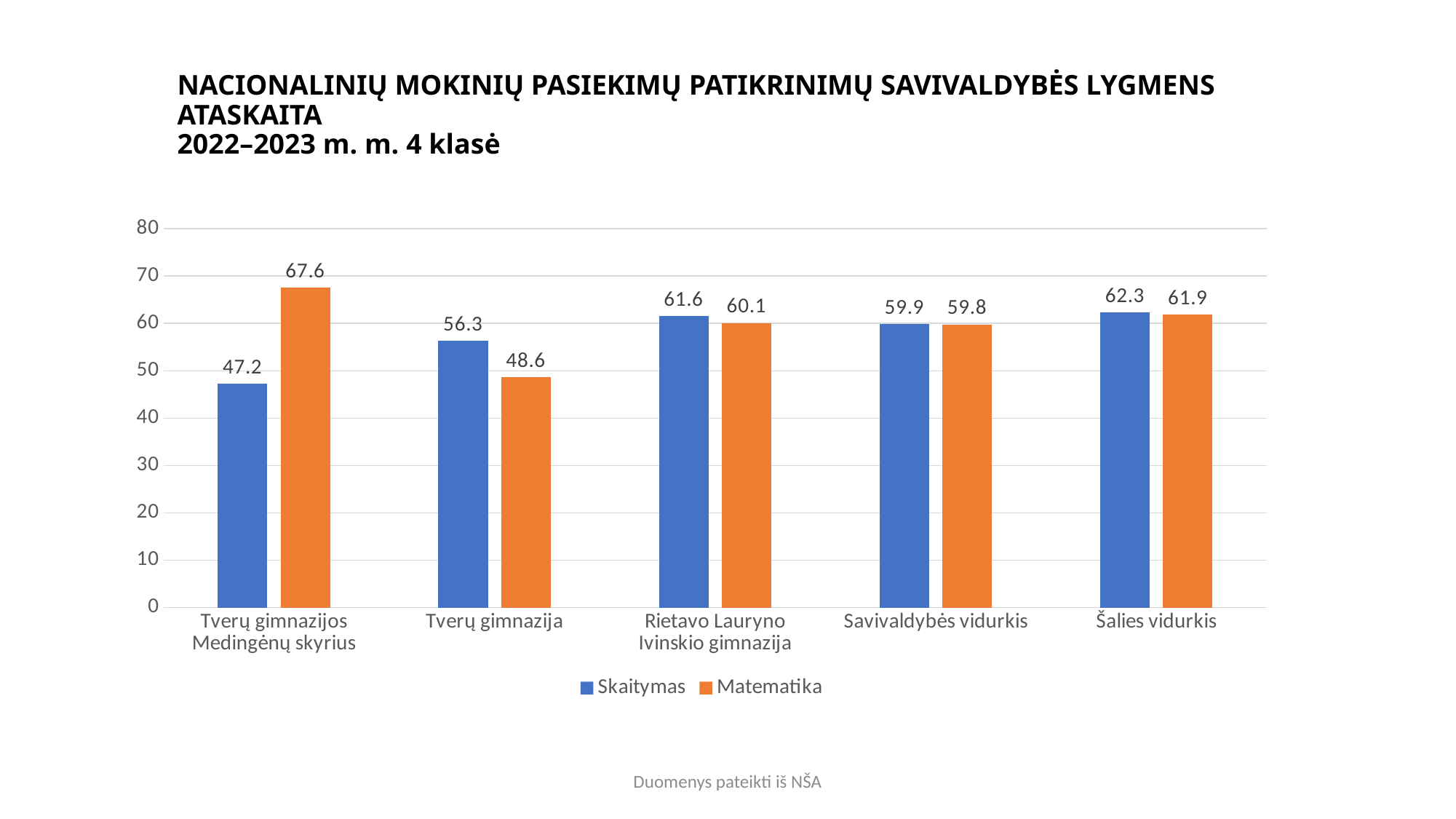
How many series does the legend list? 2 What is the Skaitymas value for Šalies vidurkis? 62.3 Which category has the highest Matematika value? Tverų gimnazijos Medingėnų skyrius What is the Matematika value for Tverų gimnazijos Medingėnų skyrius? 67.6 Which category has the lowest Skaitymas value? Tverų gimnazijos Medingėnų skyrius What is the difference between the Skaitymas and Matematika values for Tverų gimnazija? 7.7 What is the Matematika value for Rietavo Lauryno Ivinskio gimnazija? 60.1 What kind of chart is shown on the slide? Bar chart What is the Skaitymas value for Tverų gimnazija? 56.3 Which is larger for Tverų gimnazija: the Skaitymas value or the Matematika value? Skaitymas How many categories are shown on the x axis? 5 What is the difference between the Matematika and Skaitymas values for Tverų gimnazijos Medingėnų skyrius? 20.4